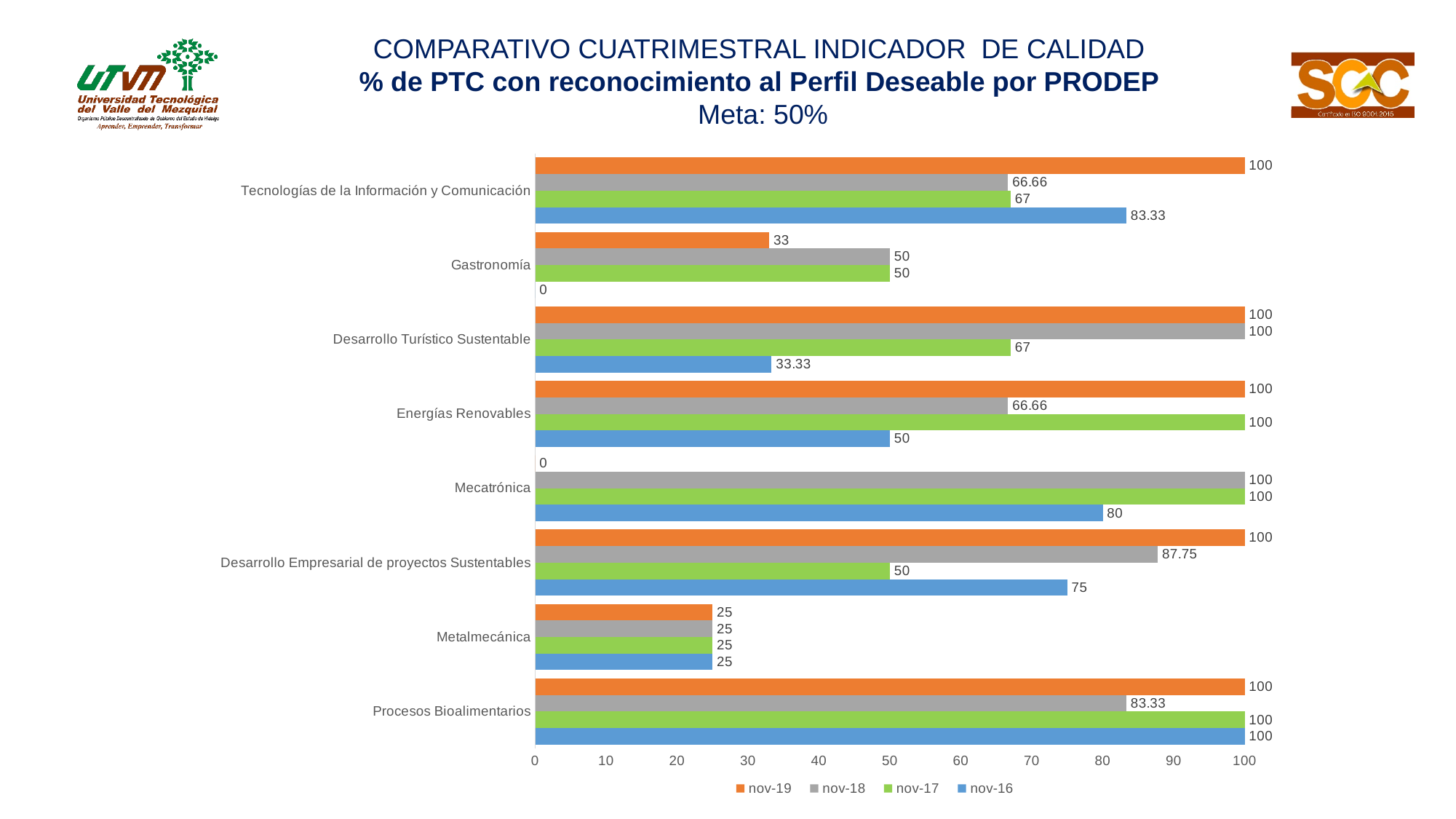
What is the nov-19 value for Mecatrónica? 0 How many categories are shown on the chart? 8 What kind of chart is shown on the slide? bar chart What is the target (Meta) stated in the chart title? 50% What is the difference between the nov-19 and nov-16 values for Desarrollo Turístico Sustentable? 66.67 Is the nov-16 value for Mecatrónica greater or less than 70? greater Which category has the lowest nov-16 value? Gastronomía What is the nov-18 value for Desarrollo Empresarial de proyectos Sustentables? 87.75 What is the nov-16 value for Tecnologías de la Información y Comunicación? 83.33 What is the nov-19 value for Gastronomía? 33 How many series does the legend list? 4 Which is larger for Energías Renovables, the nov-18 value or the nov-17 value? nov-17